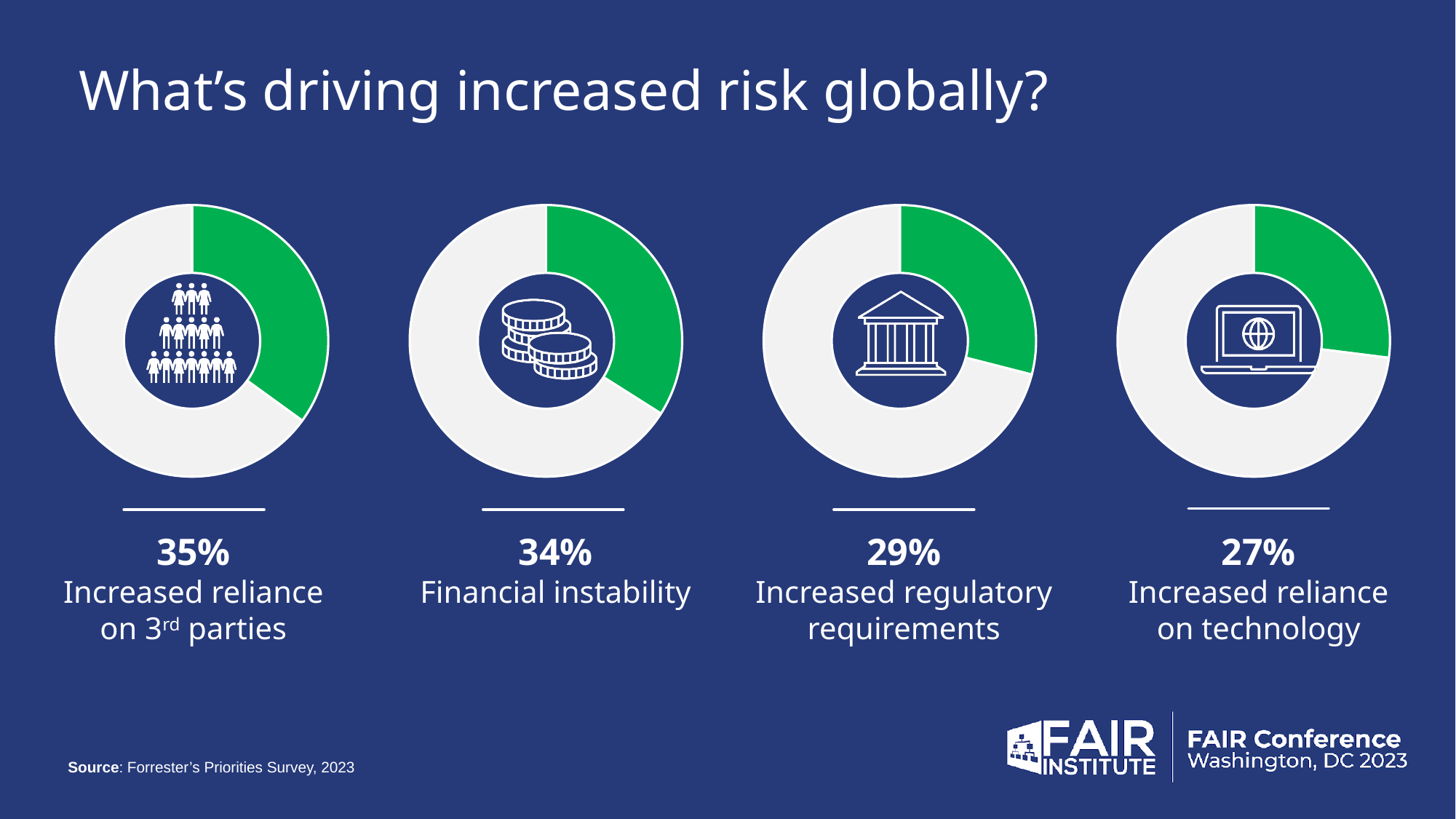
What percentage is shown for Increased regulatory requirements? 29% How many donut charts are shown on the slide? 4 What is the difference in percentage points between Financial instability and Increased regulatory requirements? 5 Which driver of increased risk has the lowest percentage on the slide? Increased reliance on technology What percentage is shown for Increased reliance on 3rd parties? 35% Which has a larger percentage, Increased regulatory requirements or Increased reliance on technology? Increased regulatory requirements What percentage is shown for Increased reliance on technology? 27% What percentage is shown for Financial instability? 34% What kind of chart is used to show each percentage on the slide? Donut chart Which driver of increased risk has the highest percentage on the slide? Increased reliance on 3rd parties What is the source cited for the data on the slide? Forrester's Priorities Survey, 2023 What is the difference in percentage points between Increased reliance on 3rd parties and Increased reliance on technology? 8